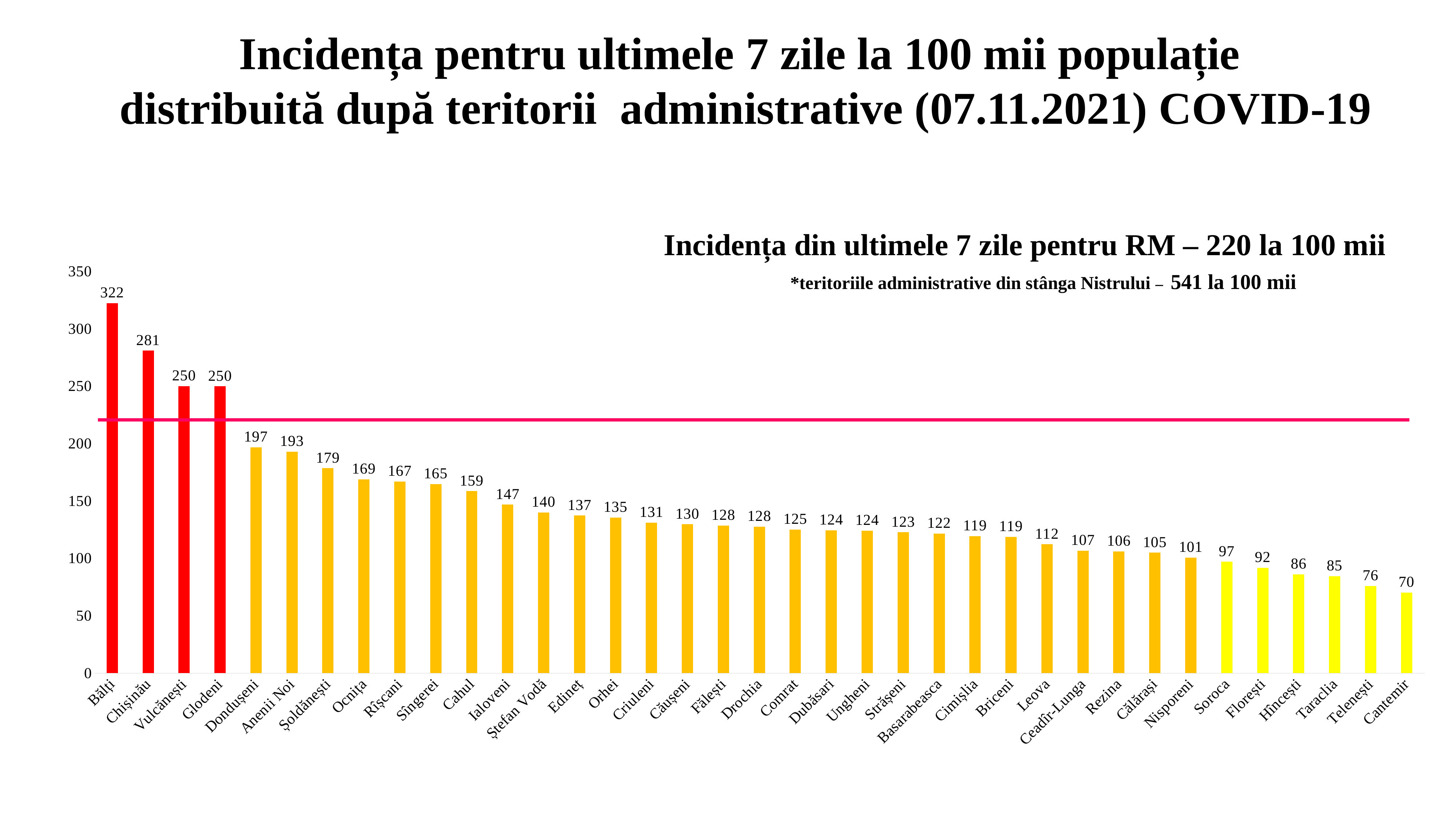
What is the difference between the values for Bălți and Chișinău? 41 Which has a higher value, Dondușeni or Soroca? Dondușeni Do the values rise or fall from left to right along the x axis? Fall Which territory has the lowest incidence on the chart? Cantemir How many territories are shown on the chart? 37 Which territory has the highest incidence on the chart? Bălți What is the incidence value shown for Bălți? 322 What is the value shown for Cahul? 159 What is the incidence value shown for Chișinău? 281 What is the value shown for Cantemir? 70 What kind of chart is shown on the slide? Bar chart What incidence value for RM is stated in the text above the chart? 220 la 100 mii